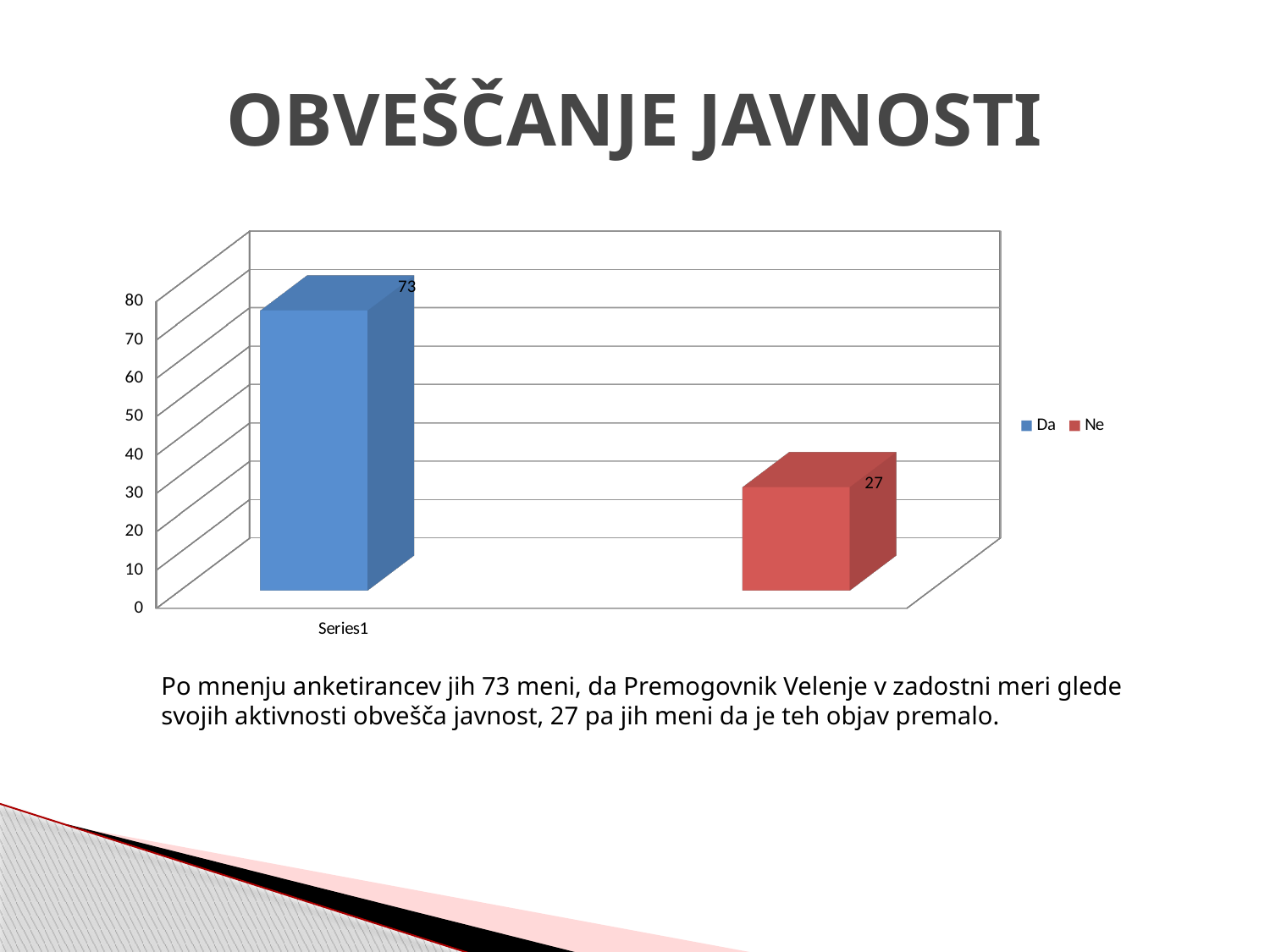
What is the difference between the values for Da and Ne? 46 What is the value for Ne? 27 What is the value for Da? 73 What kind of chart is shown on the slide? bar chart Which series has the lowest value? Ne How many series does the legend list? 2 Is the value for Ne larger or smaller than the value for Da? smaller Is the value for Da greater or less than 50? greater What is the total of the values for Da and Ne? 100 Which series has the highest value, Da or Ne? Da Is the value for Ne greater or less than 40? less What colour is the bar for Ne? red